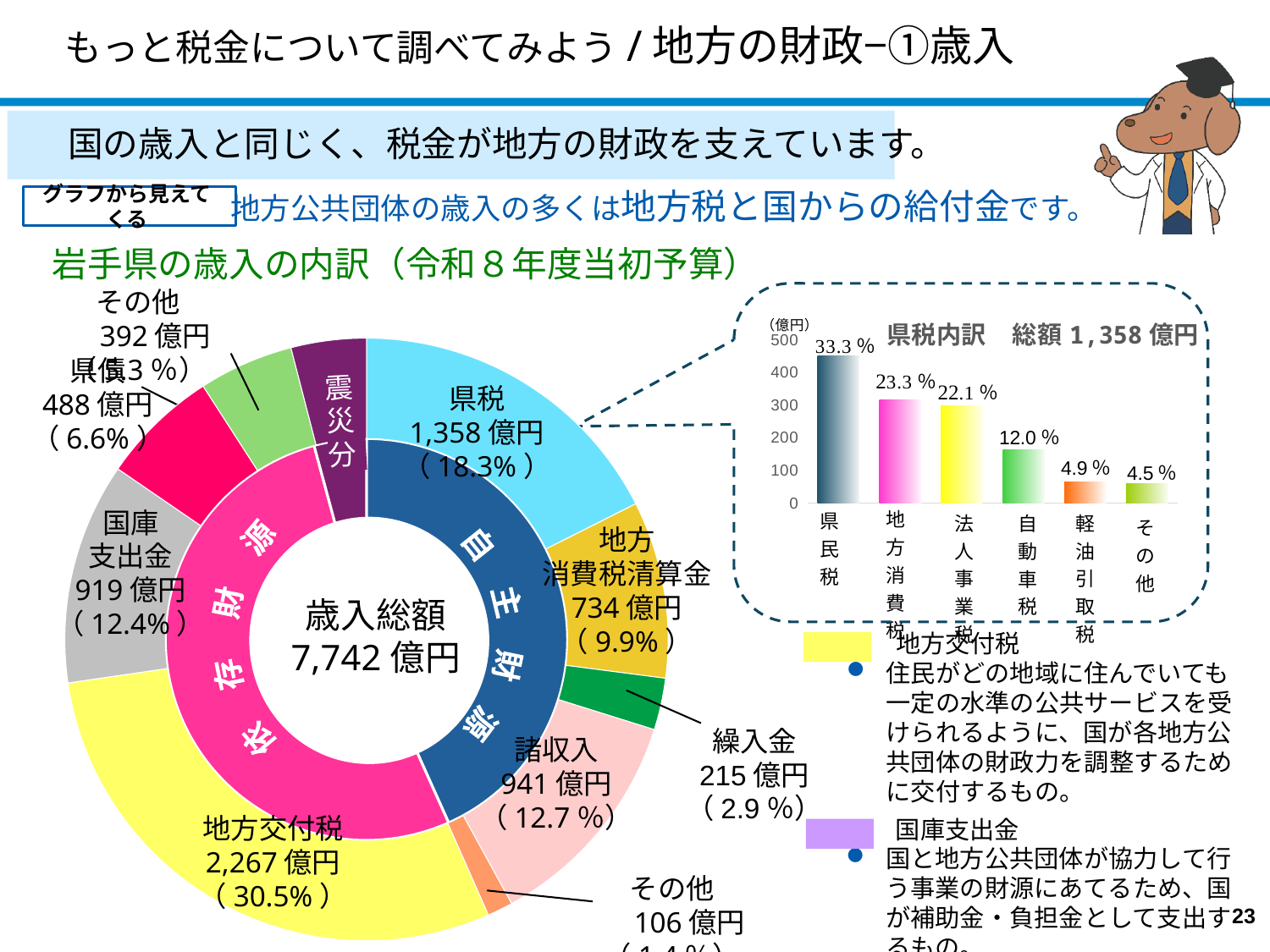
In the donut chart of 岩手県の歳入の内訳, what is the value for 繰入金? 215億円 In the donut chart of 岩手県の歳入の内訳, what is the value for 地方交付税? 2,267億円 In the donut chart of 岩手県の歳入の内訳, which labelled category has the largest value? 地方交付税 In the bar chart 県税内訳, what percentage is shown for 県民税? 33.3% In the bar chart 県税内訳, is the value for 自動車税 greater or less than 200 (億円)? less In the donut chart of 岩手県の歳入の内訳, what is the total revenue (歳入総額) shown in the centre? 7,742億円 In the bar chart 県税内訳, which category has the lowest percentage? その他 In the donut chart of 岩手県の歳入の内訳, what percentage share does 県税 have? 18.3% In the bar chart 県税内訳, how many categories are plotted? 6 What kind of chart is the 県税内訳 chart on the right of the slide? bar chart In the donut chart of 岩手県の歳入の内訳, what is the difference between 県税 (1,358億円) and 地方消費税清算金 (734億円)? 624億円 In the donut chart of 岩手県の歳入の内訳, which is larger, 国庫支出金 or 諸収入? 諸収入